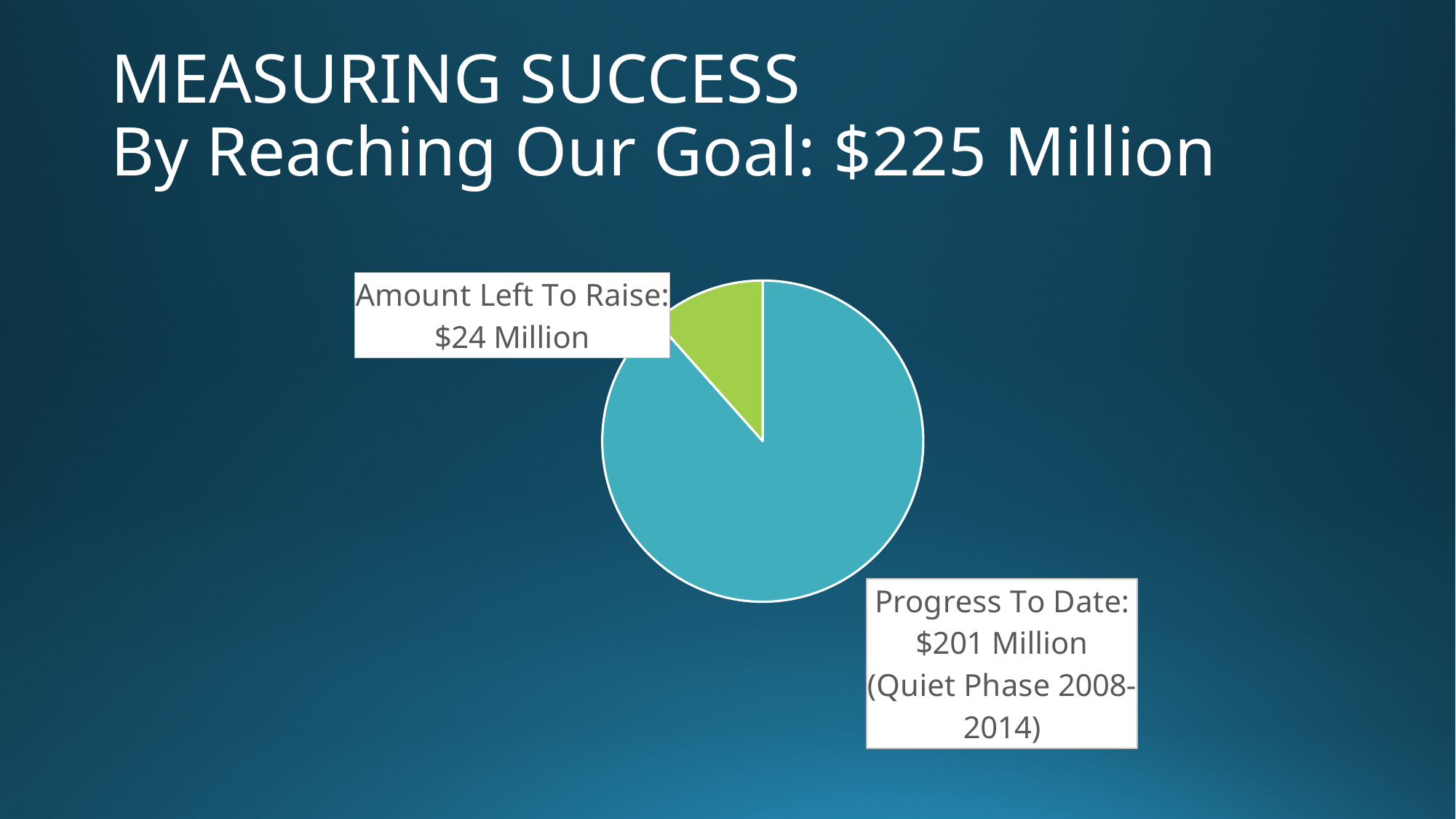
Which slice is the largest? Progress To Date What is the value of the Progress To Date slice? $201 Million What colour is the Amount Left To Raise slice? green Which is larger, Progress To Date or Amount Left To Raise? Progress To Date What is the total of the two slices in the pie chart? $225 Million What is the difference between Progress To Date and Amount Left To Raise? $177 Million Which slice is the smallest? Amount Left To Raise What kind of chart is shown on the slide? pie chart How many slices does the pie chart have? 2 What is the value of the Amount Left To Raise slice? $24 Million What period does the Progress To Date label say the quiet phase covers? 2008-2014